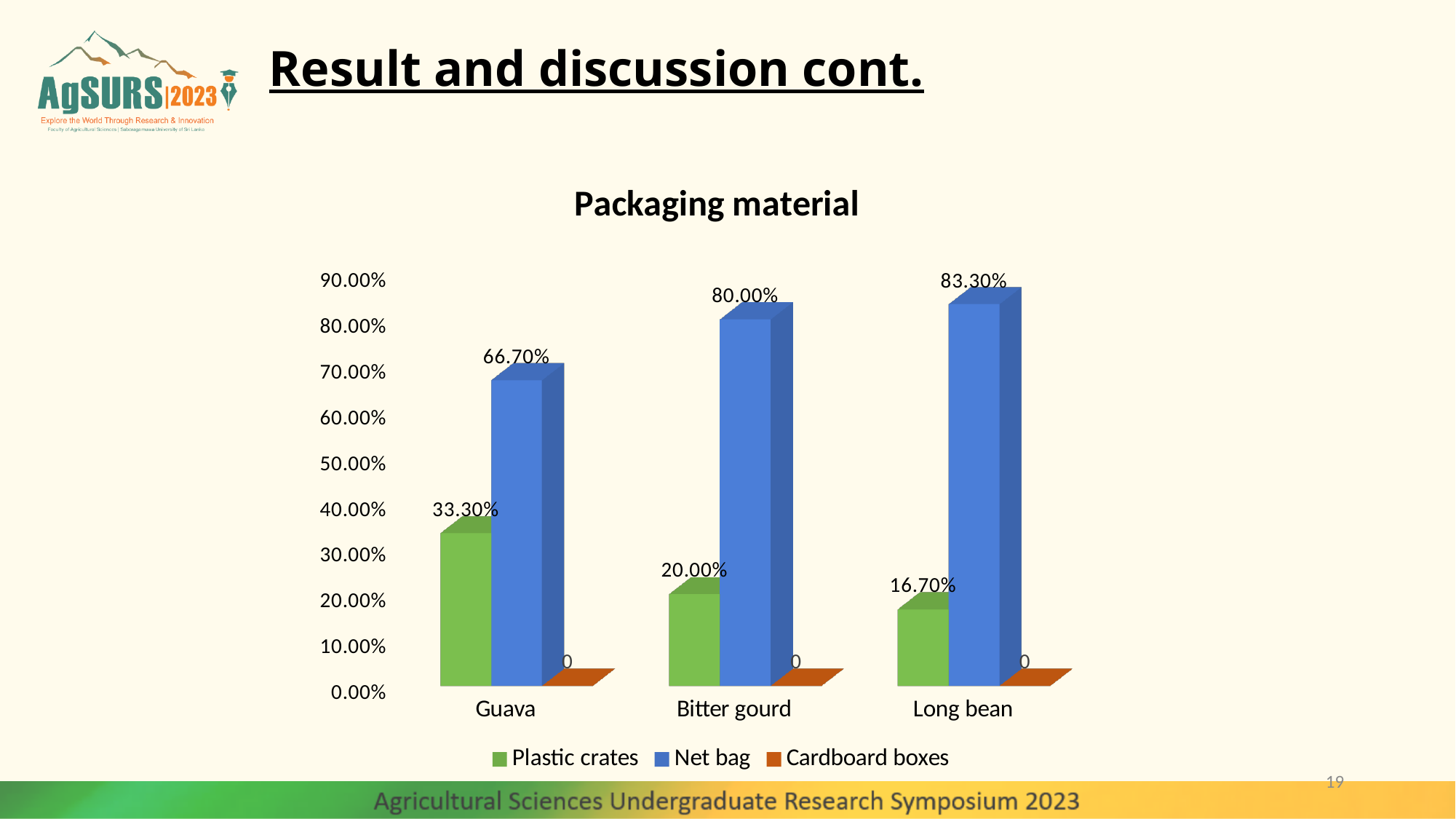
Which category has the lowest Plastic crates value? Long bean Which is larger for Bitter gourd: Plastic crates or Net bag? Net bag What is the value for Cardboard boxes for Long bean? 0 Is the Net bag value for Bitter gourd greater or less than 70.00%? greater Which category has the highest Net bag value? Long bean What is the difference between the Net bag and Plastic crates values for Guava? 33.40% What is the title of the chart? Packaging material What is the value for Net bag for Guava? 66.70% What kind of chart is shown? bar chart How many categories are shown on the x axis? 3 How many series does the legend list? 3 What is the value for Plastic crates for Bitter gourd? 20.00%